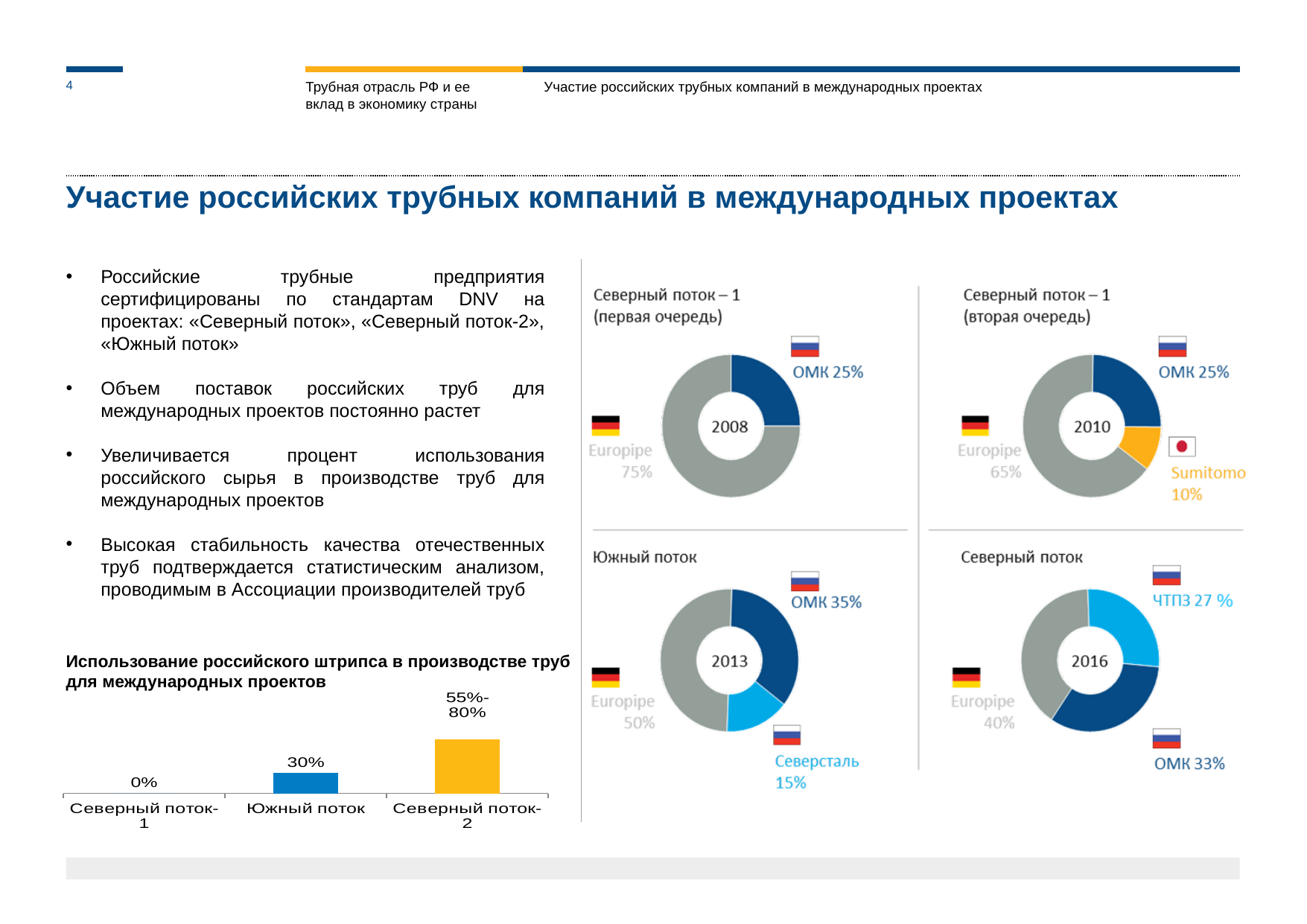
In the donut chart 'Северный поток – 1 (вторая очередь)', what share does Sumitomo have? 10% In the donut chart 'Северный поток' (2016), which is larger: the share of ЧТПЗ or the share of ОМК? ОМК In the bar chart 'Использование российского штрипса в производстве труб для международных проектов', what is the value for Южный поток? 30% In the bar chart 'Использование российского штрипса в производстве труб для международных проектов', which category has the highest value? Северный поток-2 In the donut chart 'Северный поток – 1 (первая очередь)', what share does Europipe have? 75% What type of chart is 'Использование российского штрипса в производстве труб для международных проектов'? Bar chart In the bar chart 'Использование российского штрипса в производстве труб для международных проектов', what is the value shown for Северный поток-2? 55%-80% In the donut chart 'Южный поток', what is the difference between the shares of ОМК and Северсталь? 20% In the bar chart 'Использование российского штрипса в производстве труб для международных проектов', do the values rise or fall from left to right? Rise In the donut chart 'Северный поток' (2016), which company has the largest share? Europipe In the bar chart 'Использование российского штрипса в производстве труб для международных проектов', which category has the lowest value? Северный поток-1 How many categories are shown in the bar chart 'Использование российского штрипса в производстве труб для международных проектов'? 3